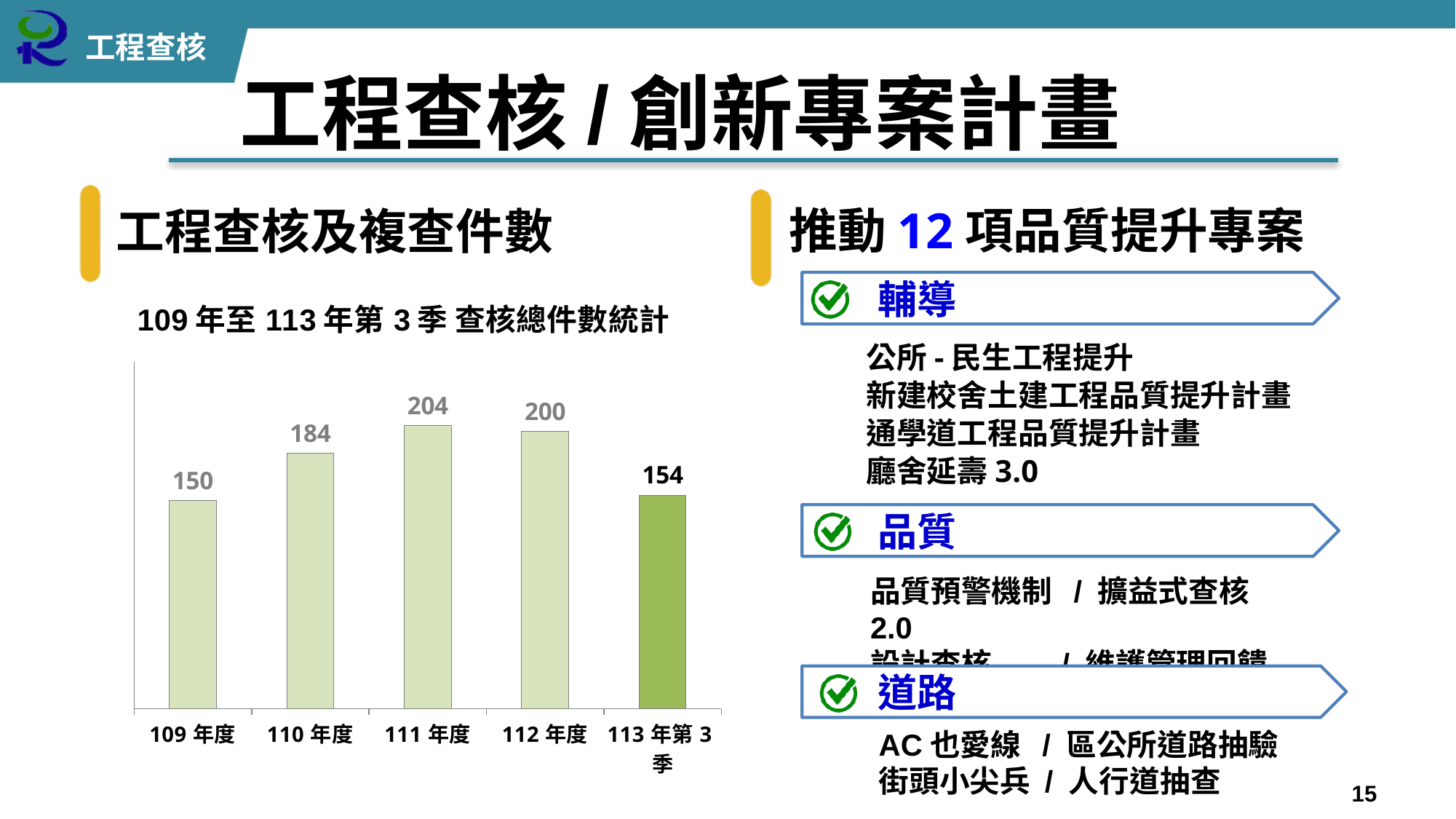
What kind of chart is shown on the slide? bar chart What is the value for 109 年度 in the chart? 150 What is the difference between the values for 112 年度 and 110 年度? 16 What is the value for 113 年第 3 季 in the chart? 154 Which category has the lowest value in the chart? 109 年度 What is the title of the chart? 109 年至 113 年第 3 季 查核總件數統計 Which is larger, the value for 110 年度 or the value for 113 年第 3 季? 110 年度 What is the value for 111 年度 in the chart? 204 Which category has the highest value in the chart? 111 年度 How many categories are shown on the x axis of the chart? 5 What is the difference between the values for 111 年度 and 109 年度? 54 Do the values rise or fall from 109 年度 to 111 年度? rise